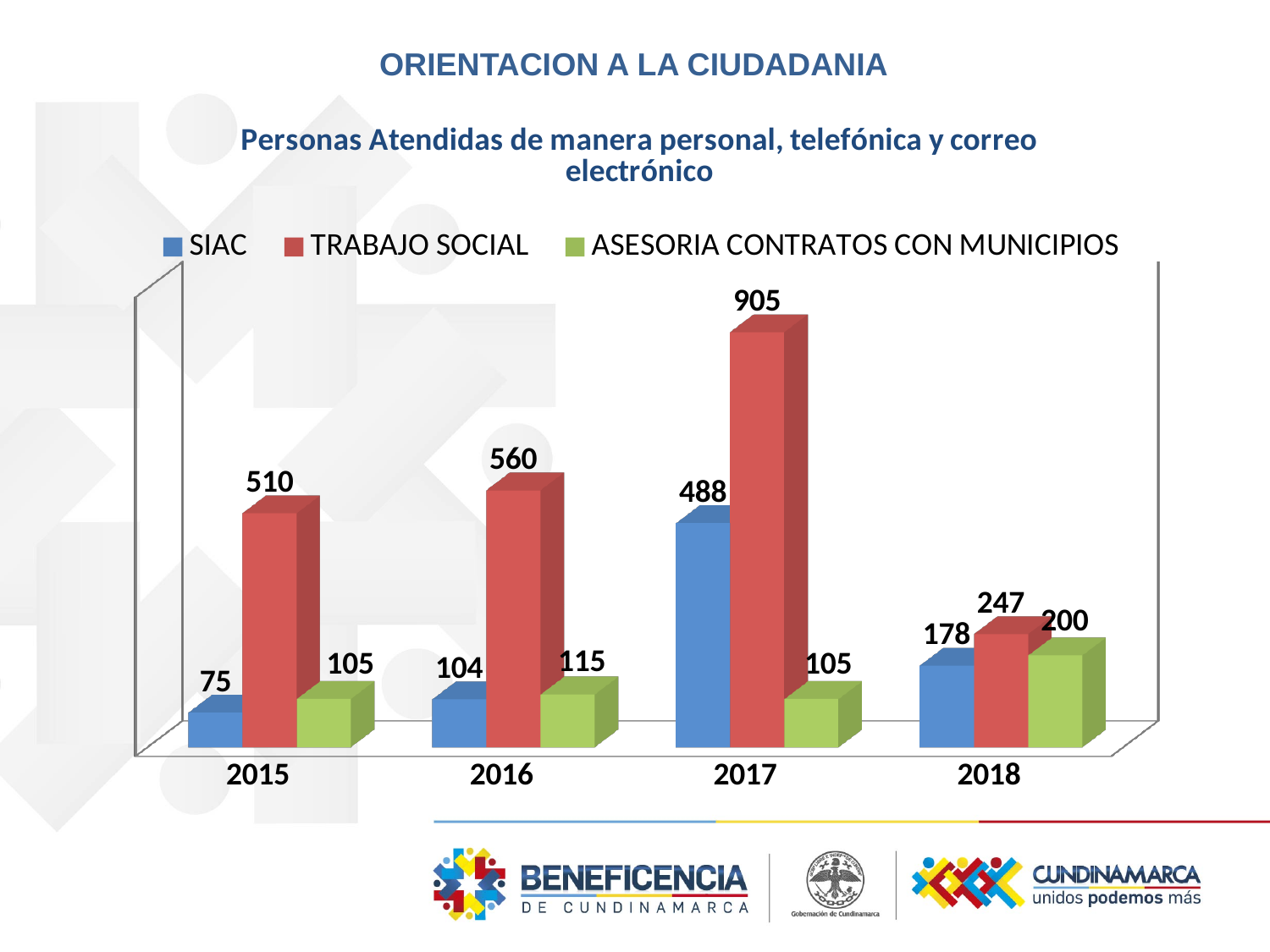
In which year is the SIAC value lowest? 2015 In which year is the TRABAJO SOCIAL value highest? 2017 Does the SIAC value rise or fall from 2015 to 2017? Rise What is the value for SIAC in 2015? 75 What is the difference between the TRABAJO SOCIAL values for 2017 and 2016? 345 Which colour represents TRABAJO SOCIAL in the legend? Red What is the value for TRABAJO SOCIAL in 2017? 905 How many years are shown on the x axis? 4 Which is larger in 2018: SIAC or ASESORIA CONTRATOS CON MUNICIPIOS? ASESORIA CONTRATOS CON MUNICIPIOS What is the value for ASESORIA CONTRATOS CON MUNICIPIOS in 2018? 200 How many series does the legend list? 3 What kind of chart is shown? Bar chart